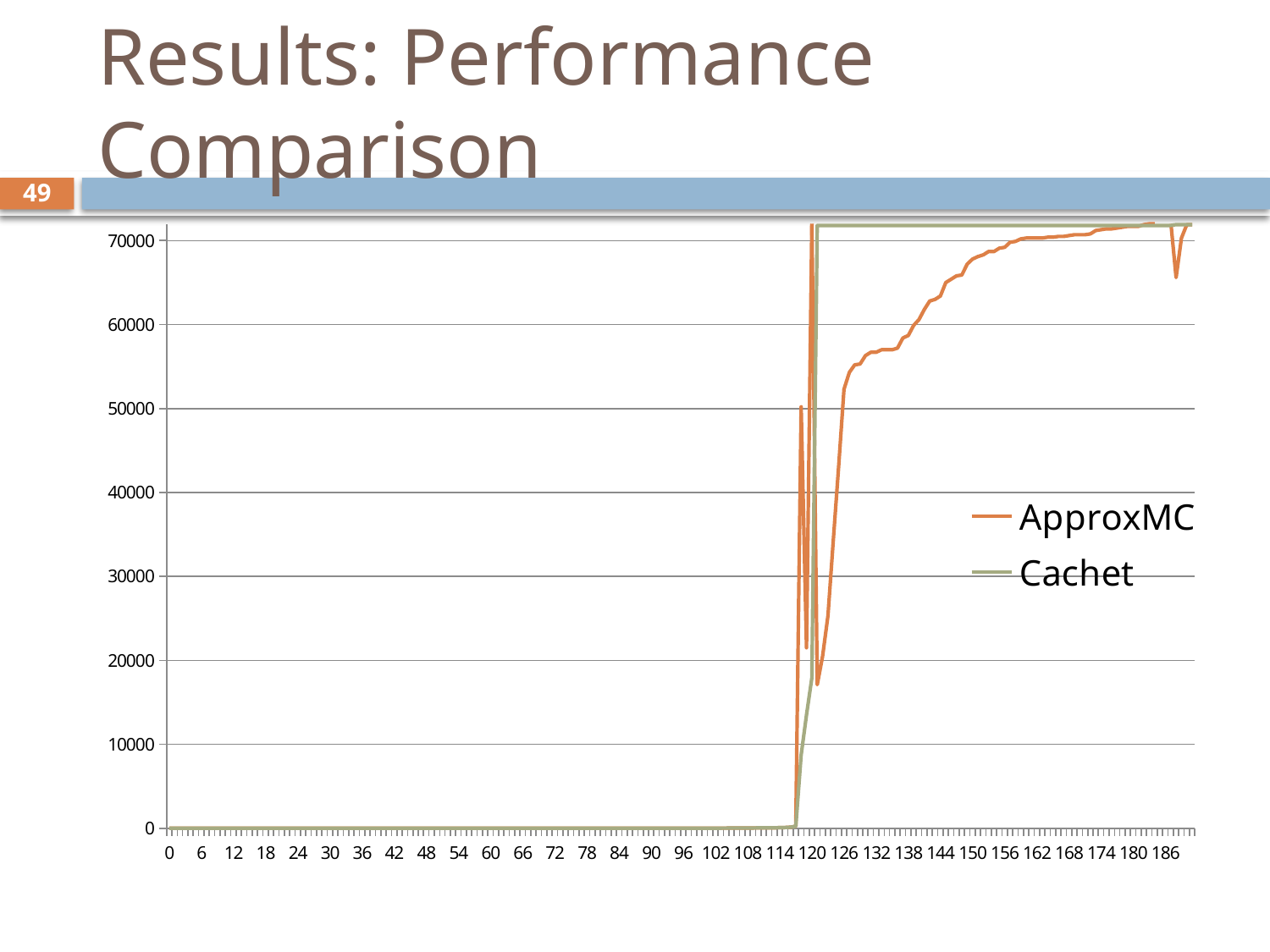
What are the two series named in the legend? ApproxMC and Cachet Which series is drawn in orange? ApproxMC At x = 138, which series has the higher value, ApproxMC or Cachet? Cachet Is the value for Cachet at x = 150 greater or less than 70000? greater What is the highest value labelled on the y axis? 70000 How many series does the legend list? 2 Is the value for ApproxMC at x = 132 greater or less than 50000? greater What kind of chart is shown on the slide? line chart Is the value for ApproxMC at x = 150 greater or less than 60000? greater Between x = 126 and x = 180, does the ApproxMC line generally rise or fall? rise